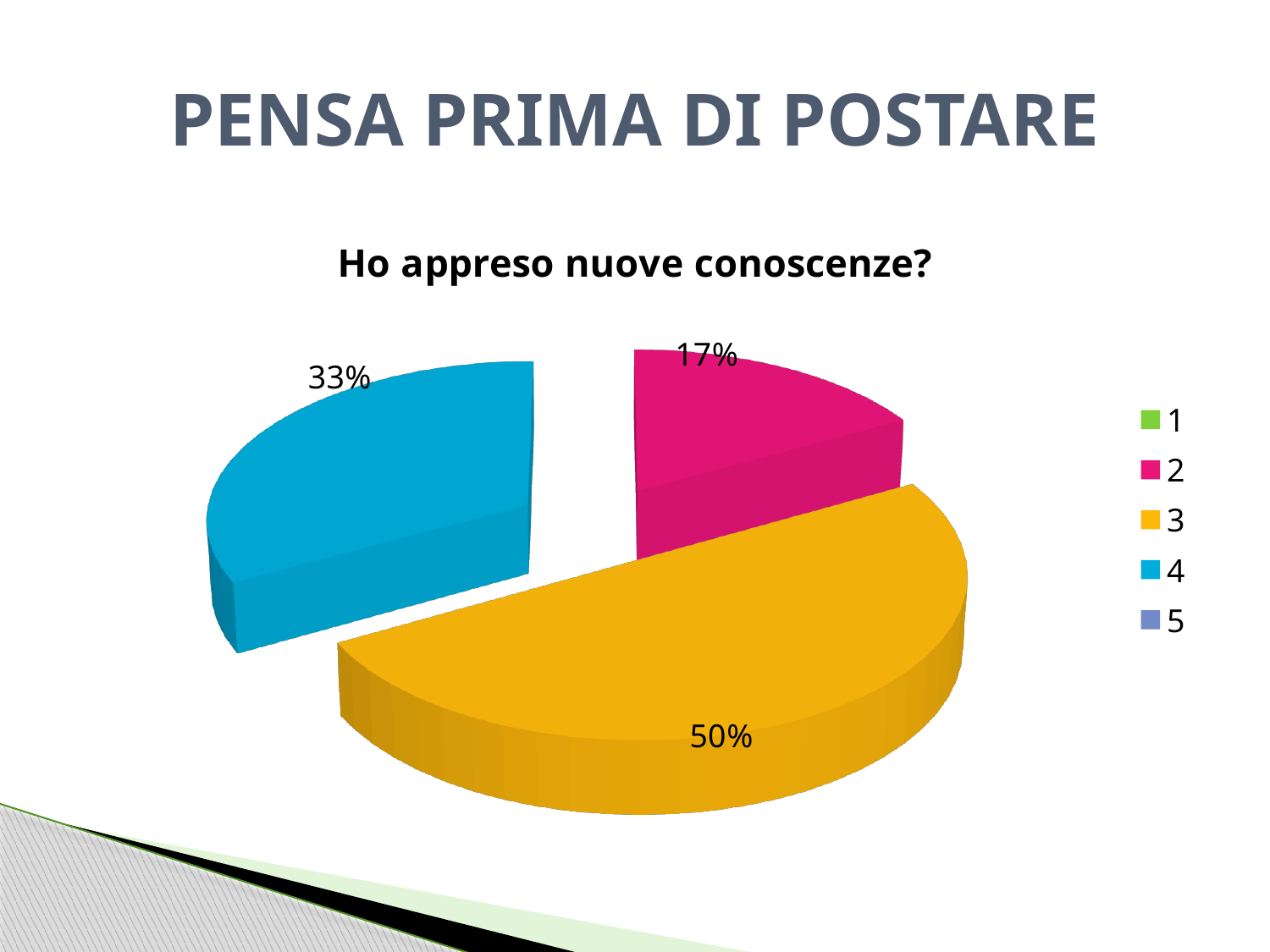
What is the title of the chart? Ho appreso nuove conoscenze? What kind of chart is shown on the slide? pie chart How many slices are visible in the pie? 3 Which of the visible slices is the smallest? 2 How many entries does the chart's legend list? 5 What colour is the slice for category 3? yellow What share of the pie does category 4 represent? 33% What share of the pie does category 2 represent? 17% Which is larger, the slice for category 4 or the slice for category 2? 4 What is the difference in percentage points between the slice for category 3 and the slice for category 4? 17 Which category has the largest slice of the pie? 3 What share of the pie does category 3 represent? 50%